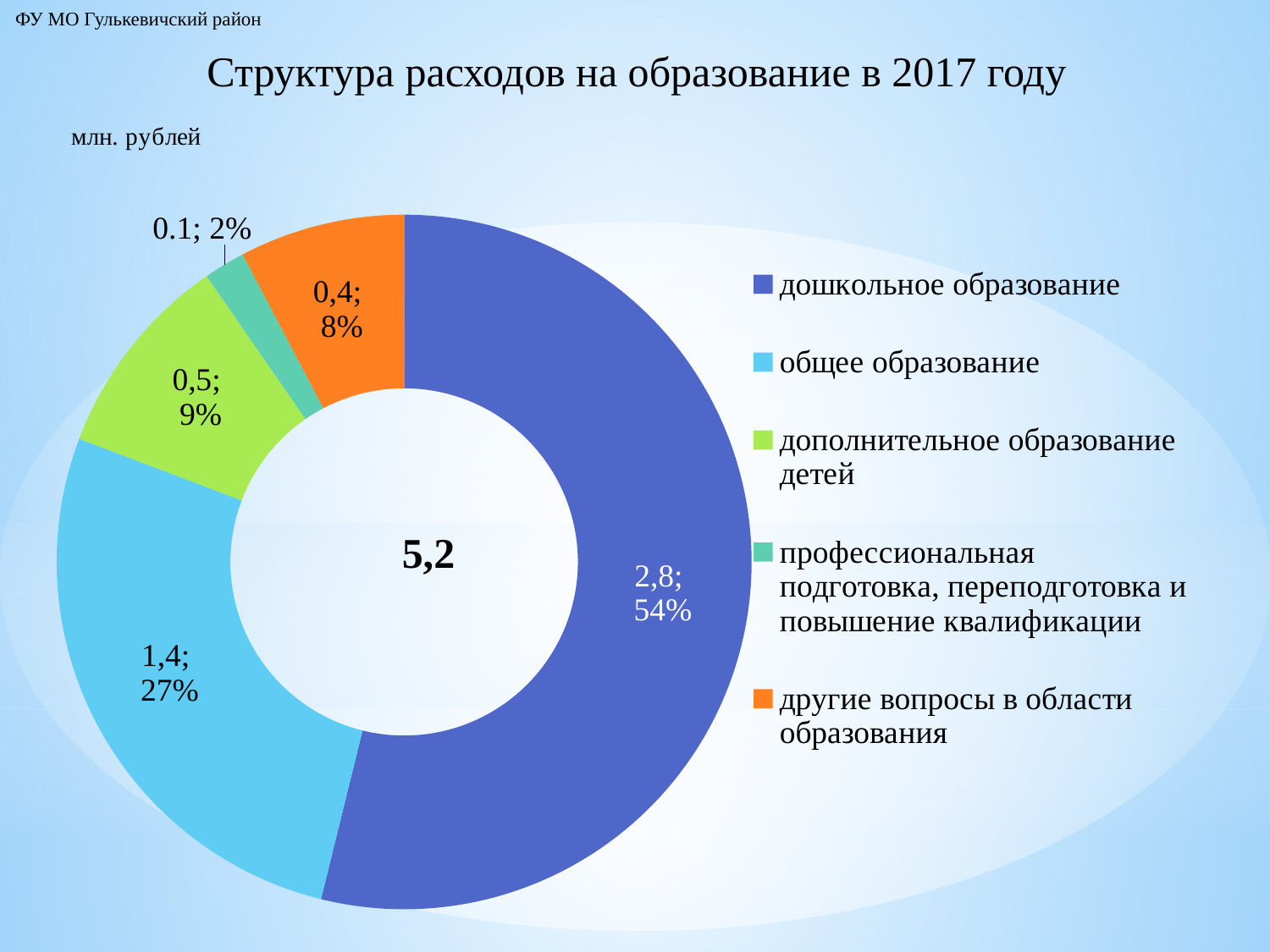
What is the value for дополнительное образование детей? 0,5 Which category has the largest share? дошкольное образование Which category has the smallest share? профессиональная подготовка, переподготовка и повышение квалификации What is the value for дошкольное образование? 2,8 What share of the chart does общее образование represent? 27% What is the difference between the values for дошкольное образование and общее образование? 1,4 What kind of chart is shown on the slide? Doughnut (pie) chart How many categories does the chart show? 5 What total value is shown in the centre of the chart? 5,2 What is the value for профессиональная подготовка, переподготовка и повышение квалификации? 0.1 Which is larger, the value for дополнительное образование детей or the value for другие вопросы в области образования? дополнительное образование детей What share of the chart does другие вопросы в области образования represent? 8%